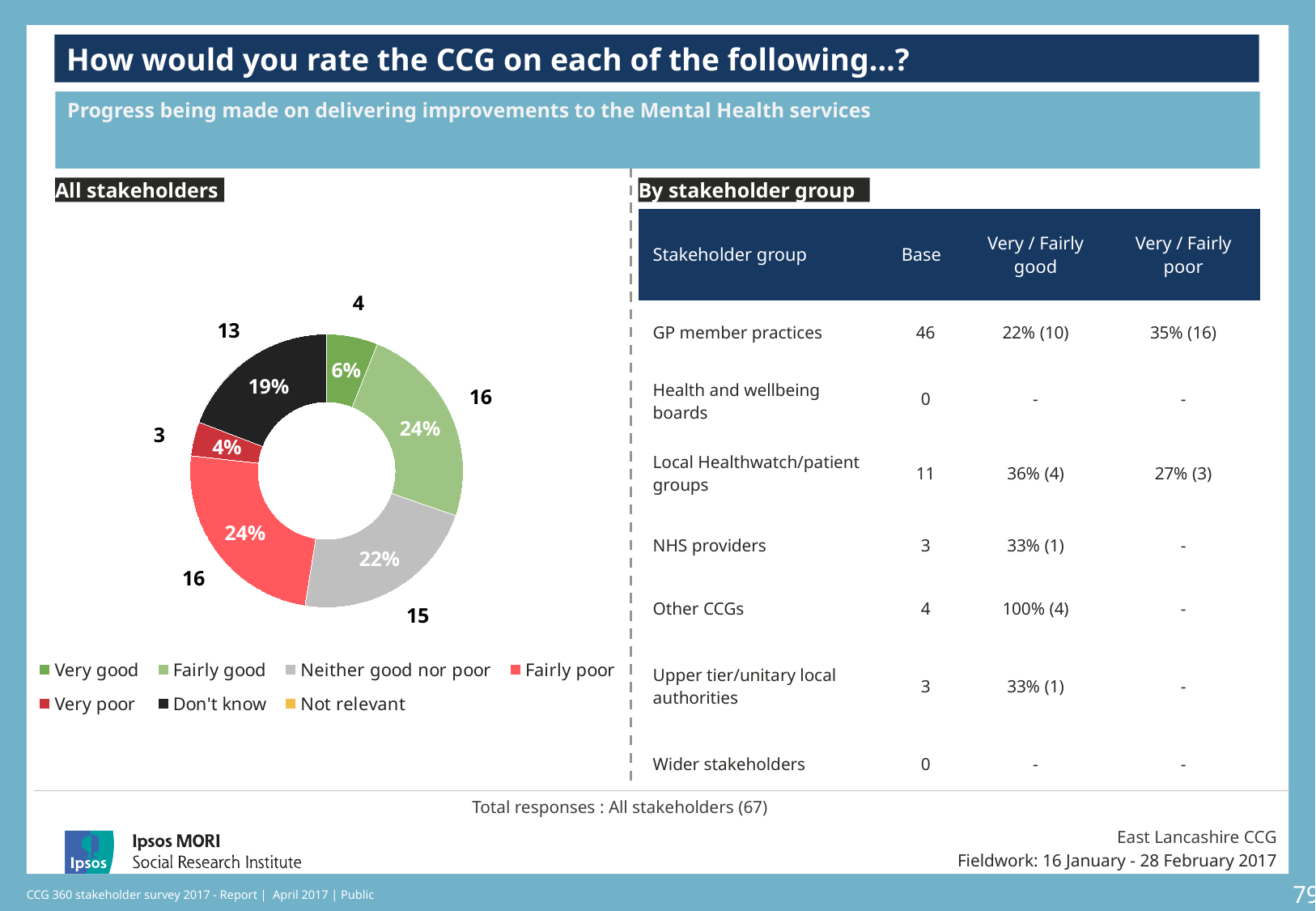
What is the difference in percentage points between 'Fairly good' and 'Very good' in the All stakeholders chart? 18 What is the total number of responses shown for all stakeholders? 67 Which rating has the smallest slice in the All stakeholders chart? Very poor What colour represents 'Don't know' in the All stakeholders chart? Black Which is larger in the All stakeholders chart: 'Don't know' or 'Very poor'? Don't know What type of chart is used for the All stakeholders data? Donut (pie) chart How many respondents answered 'Don't know' in the All stakeholders chart? 13 What percentage of all stakeholders answered 'Neither good nor poor'? 22% How many respondents rated the CCG as 'Fairly poor' in the All stakeholders chart? 16 What percentage of all stakeholders rated the CCG as 'Very good'? 6% What is the combined number of respondents for 'Fairly good' and 'Very good' in the All stakeholders chart? 20 How many entries does the legend of the All stakeholders chart list? 7